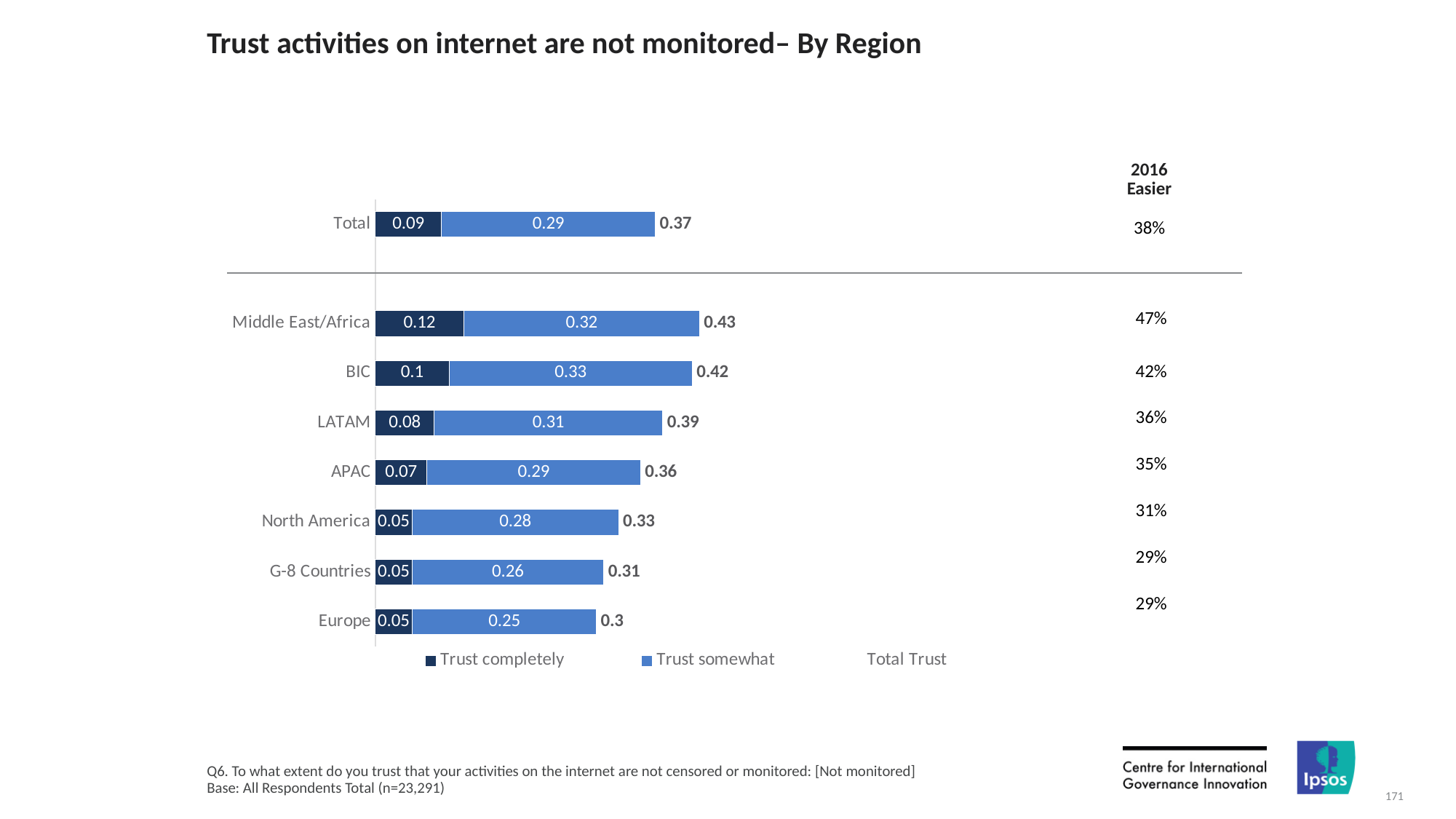
How many region categories are plotted in the chart, including Total? 8 What type of chart is shown on the slide? bar chart What is the title of the chart? Trust activities on internet are not monitored– By Region What is the difference between the Total Trust values for BIC and Europe? 0.12 Which region has the highest Total Trust value? Middle East/Africa How many entries does the legend list? 3 Which region has the lowest Total Trust value? Europe What is the 2016 Easier value shown for North America? 31% What is the 'Trust somewhat' value for BIC? 0.33 What is the 'Trust completely' value for Middle East/Africa? 0.12 What is the Total Trust value for LATAM? 0.39 Which has a larger 'Trust somewhat' value, APAC or G-8 Countries? APAC